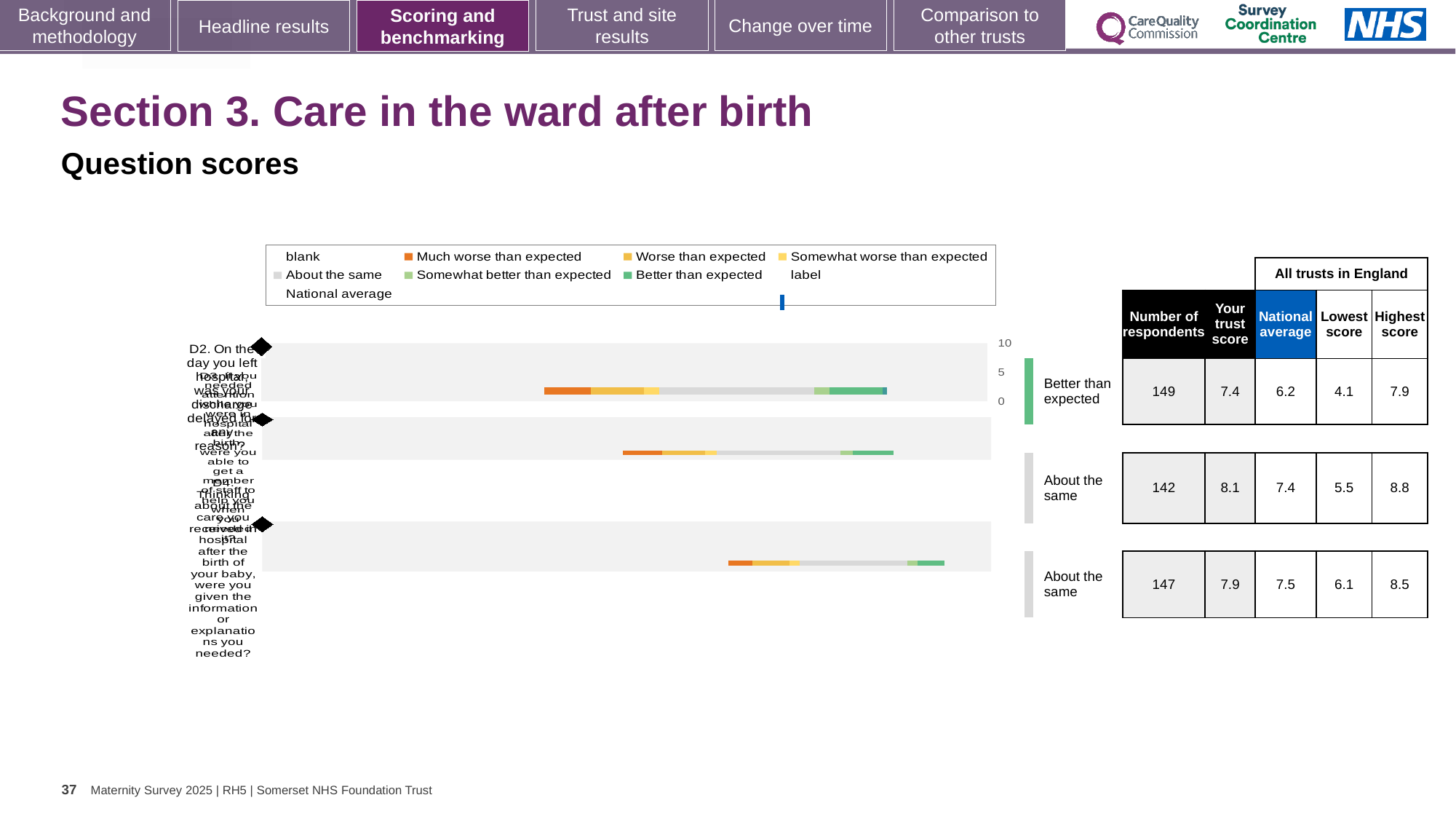
In the chart legend, what colour represents 'Much worse than expected'? orange In the table beside the chart, what is the 'National average' for the top row? 6.2 For the second row, what is the difference between 'Your trust score' and the 'National average'? 0.7 In the table beside the chart, what is 'Your trust score' for the top row? 7.4 In the chart legend, what colour represents 'Better than expected'? green What benchmark label is shown next to the top bar of the chart? Better than expected How many bars (question rows) are plotted in the chart? 3 In the table beside the chart, what is the 'Highest score' for the third (bottom) row? 8.5 In the table beside the chart, which row has the highest 'Your trust score'? the second (middle) row, 8.1 In the table beside the chart, what is the 'Number of respondents' for the second row? 142 For the top row, which is larger: 'Your trust score' or the 'National average'? Your trust score What kind of chart is shown on the slide? bar chart